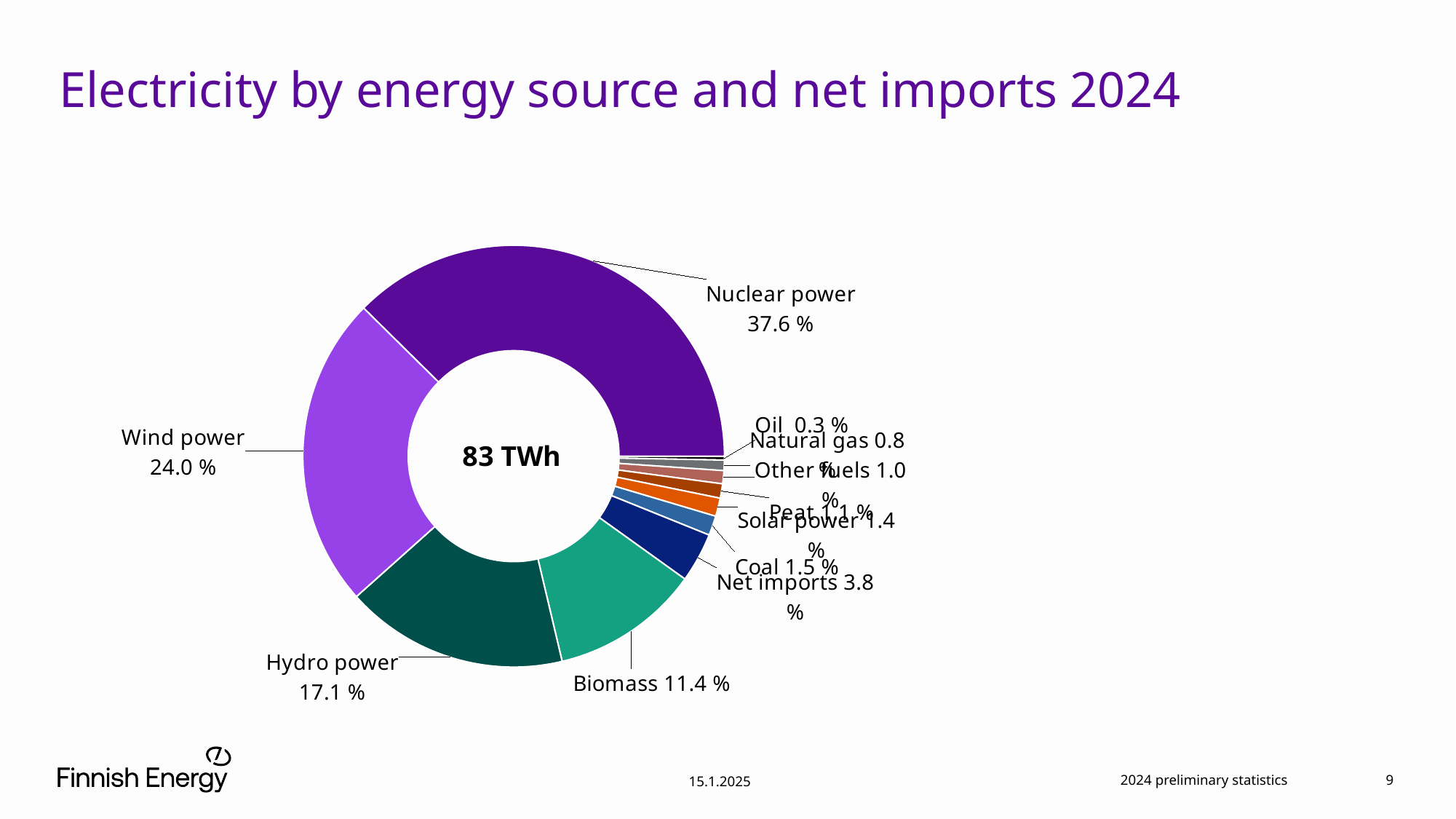
Which energy source has the largest share of the chart? Nuclear power What is the value shown for Biomass? 11.4 % What is the value shown for Wind power? 24.0 % Which energy source has the smallest share of the chart? Oil What total is printed in the centre of the chart? 83 TWh Which has a larger share, Hydro power or Biomass? Hydro power What percentage is shown for Hydro power? 17.1 % How many categories are shown in the chart? 11 What share is shown for Net imports? 3.8 % What share of electricity does Nuclear power account for? 37.6 % What is the difference in percentage points between Nuclear power and Wind power? 13.6 What kind of chart is shown on the slide? Doughnut (pie) chart